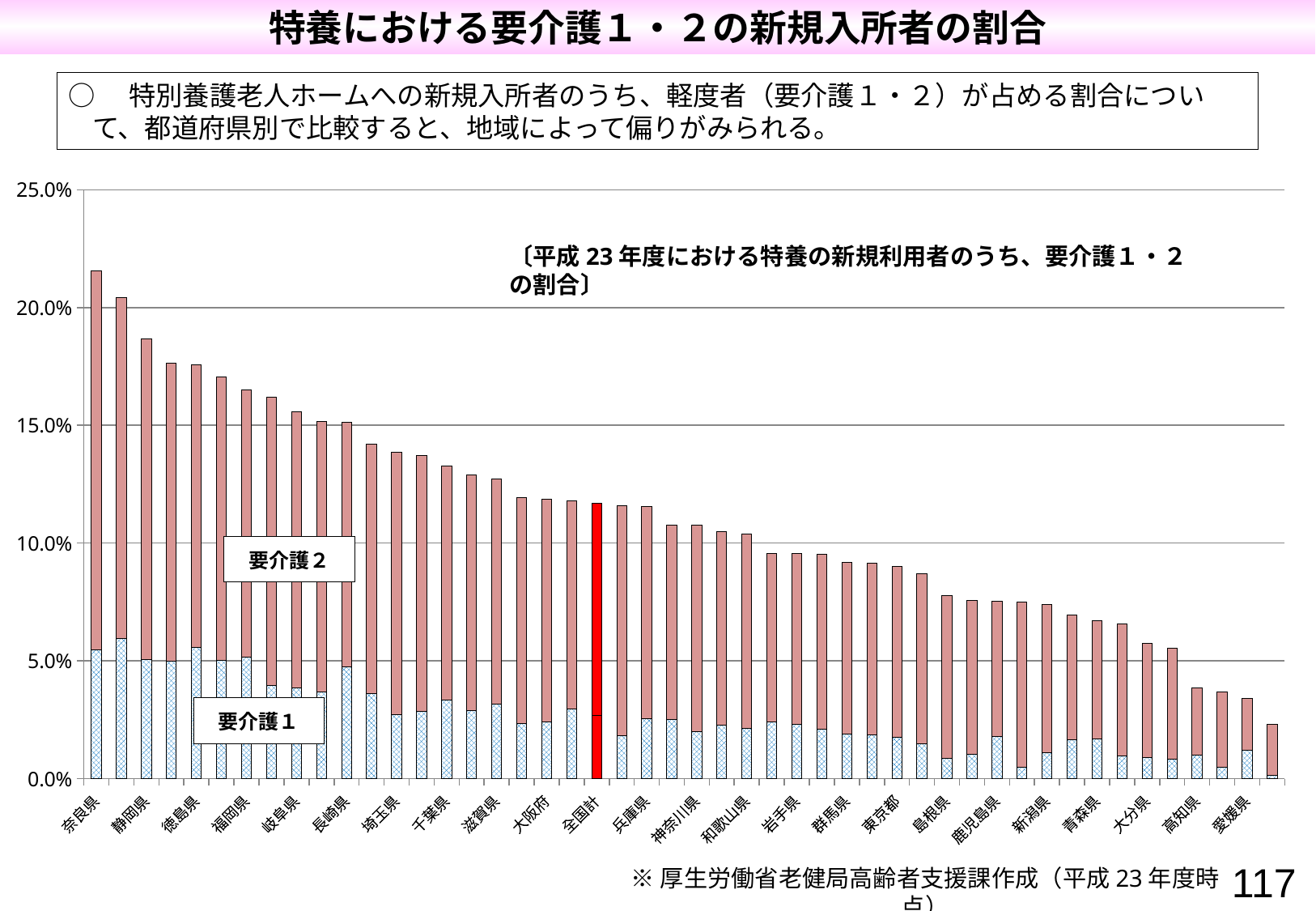
Do the bar values rise or fall from left to right along the x axis? Fall Which has a larger total value, 高知県 or 大阪府? 大阪府 What colour is the bar for 全国計? Red Is the total value for 愛媛県 greater or less than 5.0%? less Is the total value for 徳島県 greater or less than 15.0%? greater Is the total value for 奈良県 greater or less than 20.0%? greater How many series are stacked in each bar? 2 What kind of chart is shown on the slide? Stacked bar chart Which has a larger total value, 福岡県 or 東京都? 福岡県 Which prefecture has the highest share of 要介護1・2 new residents? 奈良県